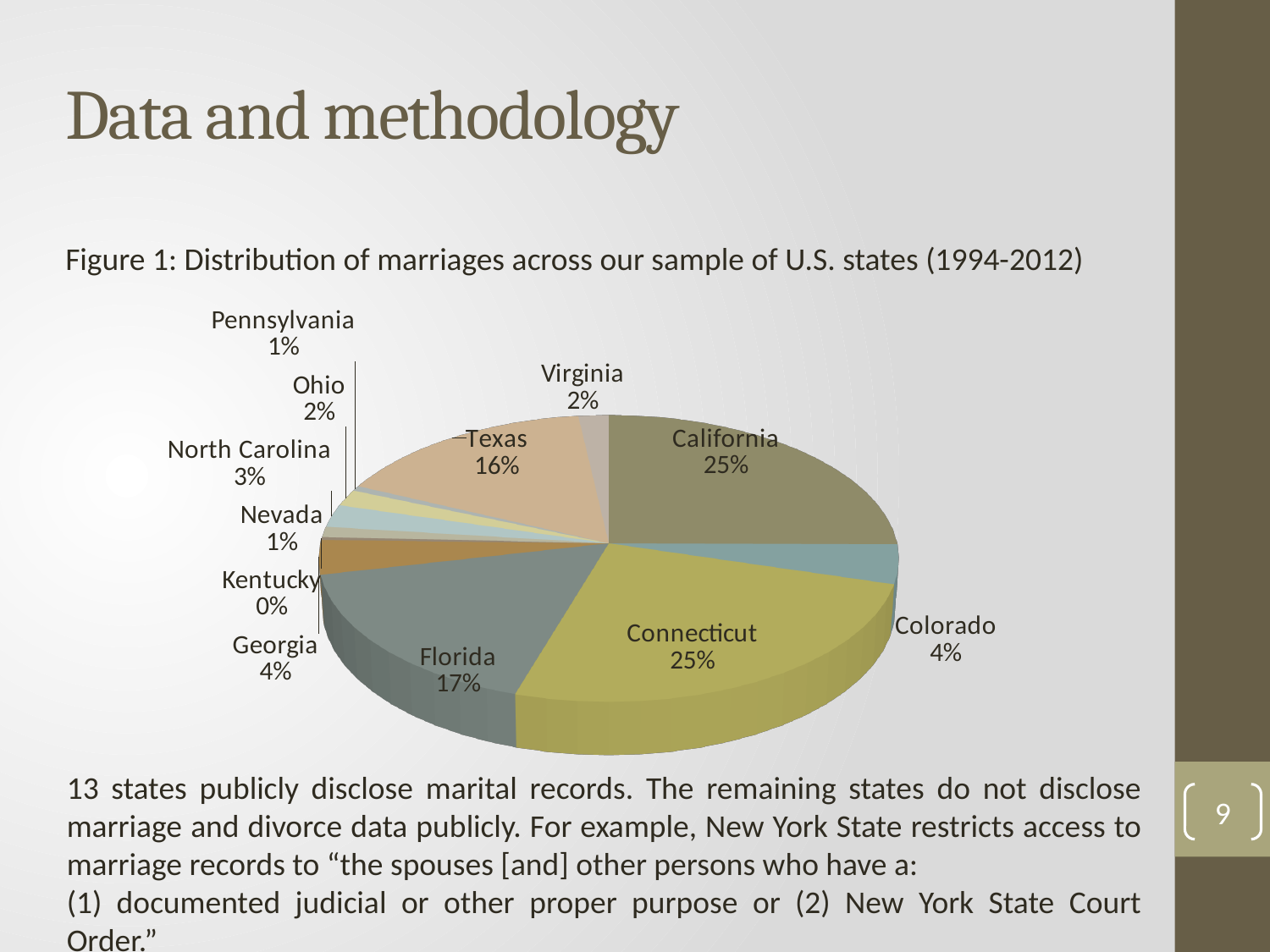
What percentage is shown for Florida? 17% What percentage is shown for Connecticut? 25% Which has the larger share, Florida or Texas? Florida What is the title of the figure shown on the slide? Figure 1: Distribution of marriages across our sample of U.S. states (1994-2012) What percentage is shown for Colorado? 4% What percentage is shown for Virginia? 2% What percentage is shown for North Carolina? 3% What kind of chart is shown on the slide? pie chart What is the difference in percentage points between Florida's and Texas's shares? 1% What share of marriages does Texas account for in the pie chart? 16% Which state has the smallest share in the pie chart? Kentucky What is the difference in percentage points between California's and Georgia's shares? 21%